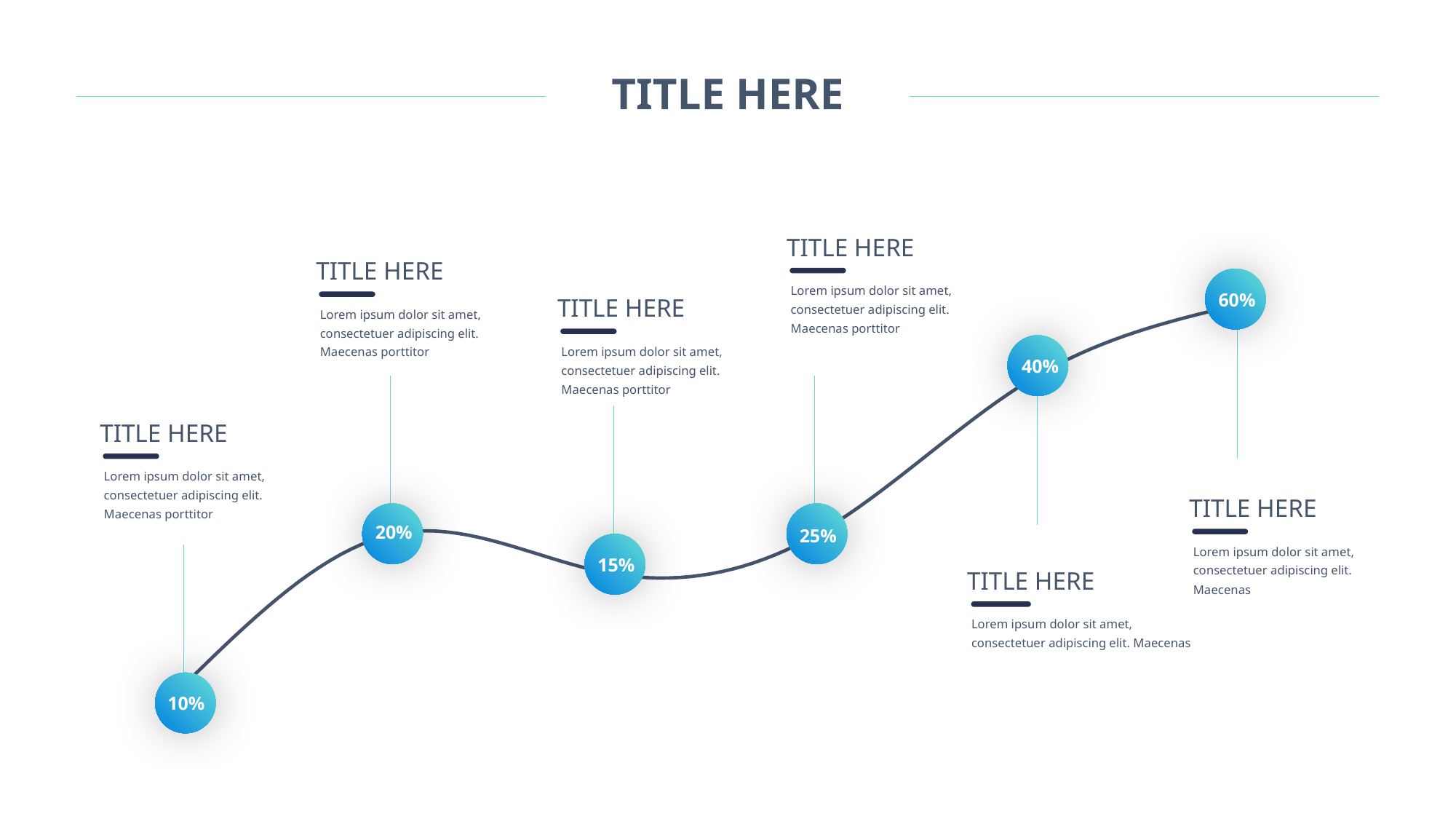
What is the value of the first (leftmost) point on the line? 10% Which is larger, the value of the second point or the value of the third point? the second point (20%) What is the lowest value shown on the line? 10% What is the value of the fifth point from the left on the line? 40% How many data points are plotted on the line? 6 What is the difference between the second point (20%) and the third point (15%)? 5% What is the highest value shown on the line? 60% What is the title of the slide? TITLE HERE What kind of chart is shown on the slide? line chart What is the difference between the last point (60%) and the first point (10%)? 50% What is the value of the third point from the left on the line? 15% Does the value of the line rise or fall between the fourth point and the sixth point? rise